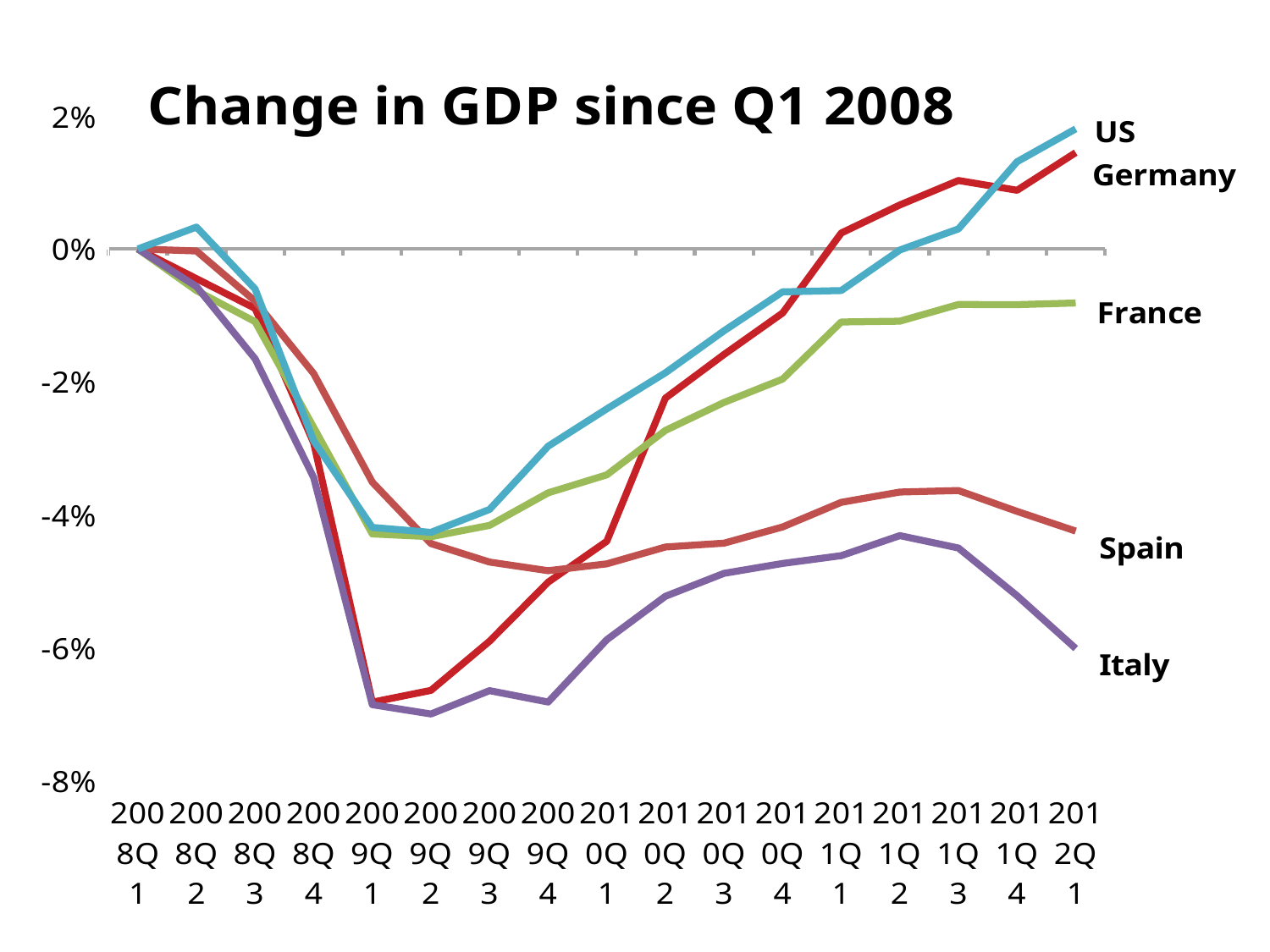
Is the value for France at 2012Q1 greater or less than 0%? less What is the title of the chart? Change in GDP since Q1 2008 How many quarters are shown along the x axis? 17 Which country has the highest value at 2012Q1? US At 2012Q1, which is higher, France or Spain? France Is the value for Italy at 2009Q2 greater or less than -6%? less Is the value for Germany at 2012Q1 greater or less than 0%? greater How many series (countries) are plotted on the chart? 5 Does the US line rise or fall from 2009Q2 to 2012Q1? rise What is the value for all countries at 2008Q1? 0% Which country has the lowest value at 2012Q1? Italy What kind of chart is shown on the slide? line chart